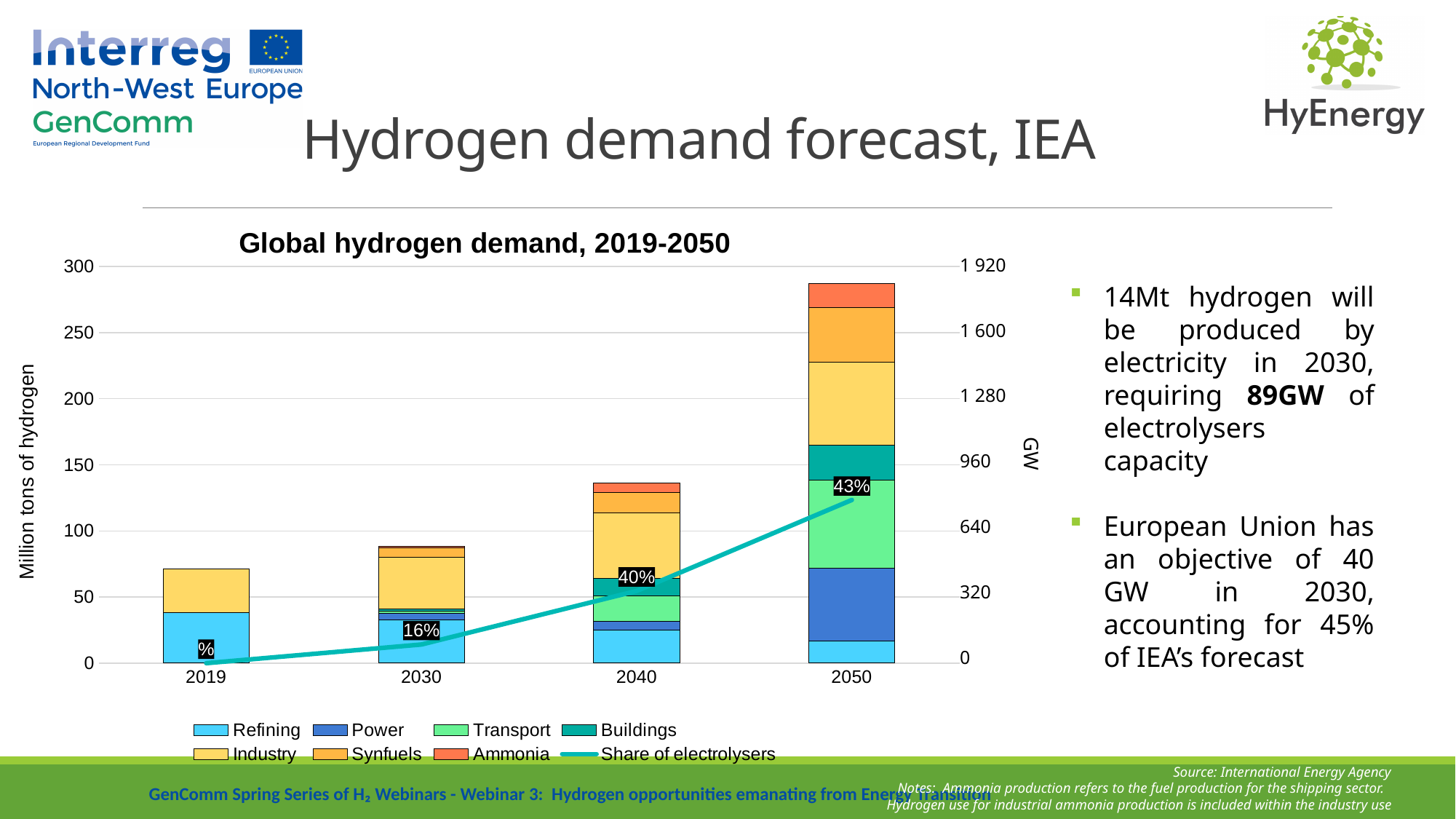
What is the share of electrolysers shown for 2030? 16% What kind of chart is used to show the hydrogen demand by sector? bar chart By how many percentage points does the share of electrolysers increase from 2040 to 2050? 3 percentage points How many years are shown on the x axis of the chart? 4 Is the total hydrogen demand for 2050 greater or less than 250 million tons? greater What is the share of electrolysers shown for 2040? 40% Does the share of electrolysers rise or fall from 2019 to 2050? rise Which year has the lowest total hydrogen demand? 2019 How many entries does the chart legend list? 8 What is the share of electrolysers shown for 2050? 43% Which year has the highest total hydrogen demand? 2050 What is the title of the chart? Global hydrogen demand, 2019-2050